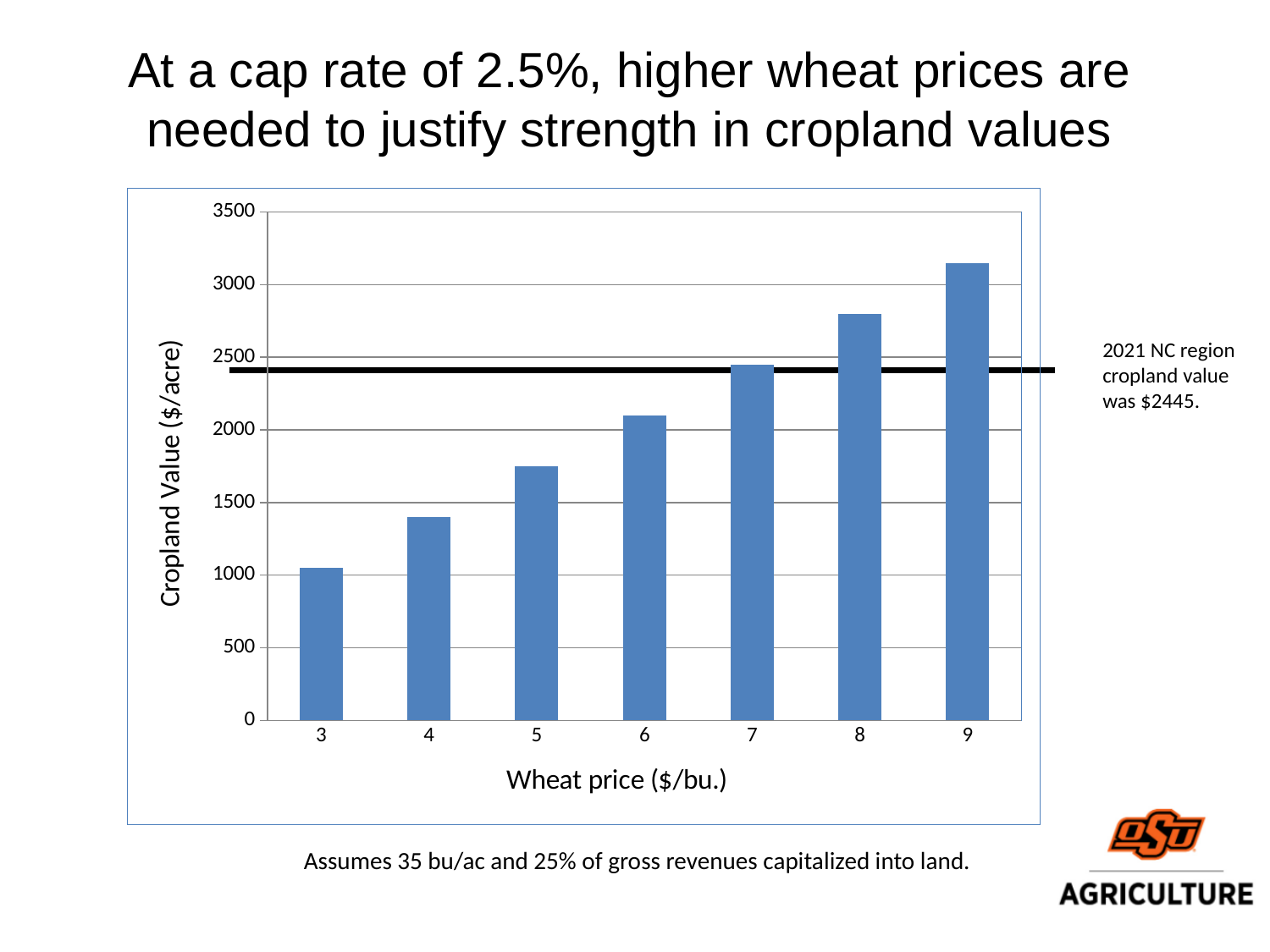
Is the cropland value at a wheat price of 5 greater or less than 1500? greater How many wheat price categories are plotted on the x axis? 7 Which wheat price has the highest cropland value? 9 According to the annotation next to the horizontal line, what was the 2021 NC region cropland value? $2445 Is the cropland value at a wheat price of 4 greater or less than 1500? less Is the cropland value at a wheat price of 8 greater or less than 2500? greater Which has the larger cropland value, a wheat price of 5 or a wheat price of 8? 8 What kind of chart is shown on the slide? bar chart Which wheat price has the lowest cropland value? 3 Do cropland values rise or fall as wheat price increases along the x axis? rise What is the label on the y axis of the chart? Cropland Value ($/acre)